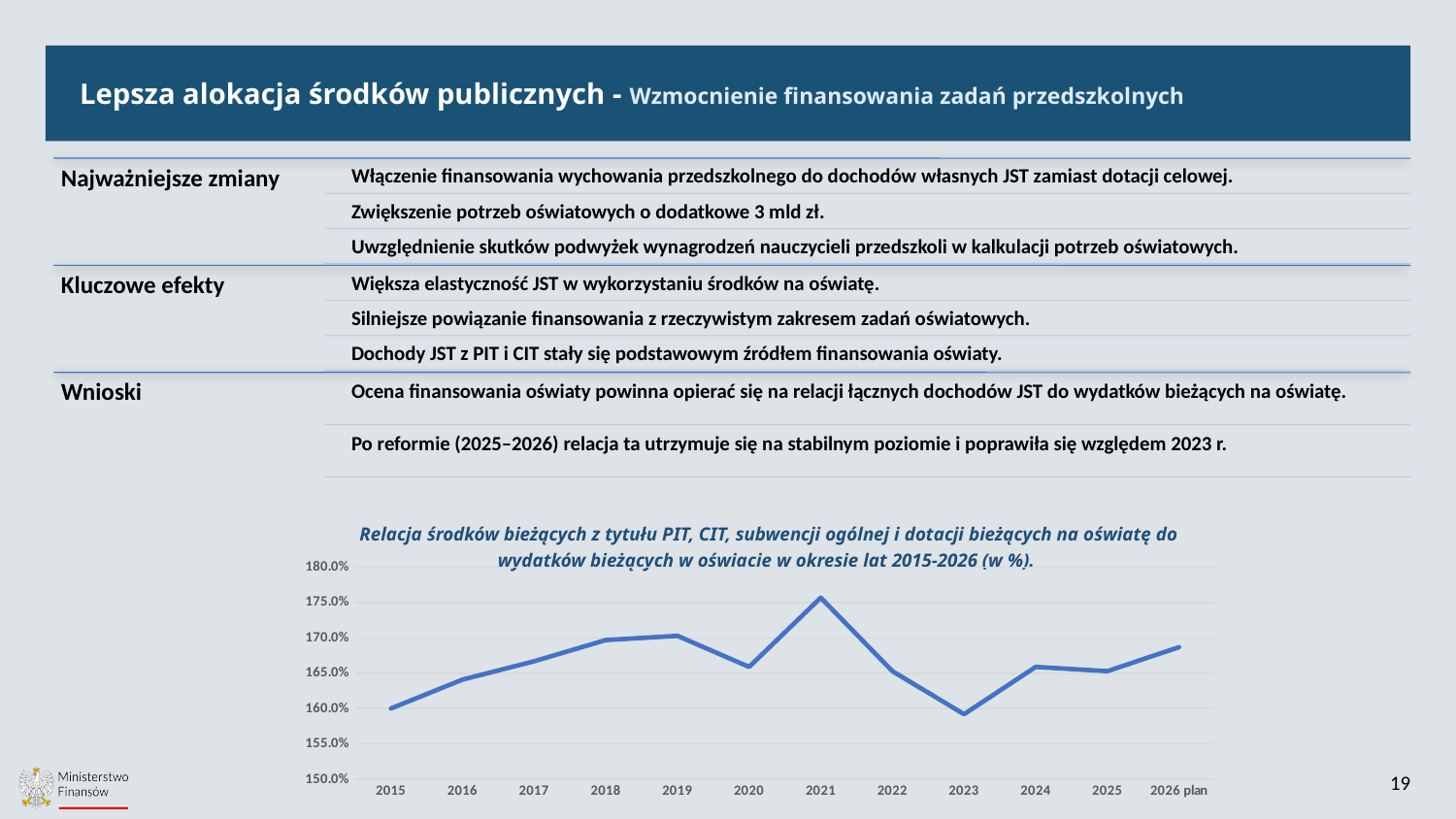
What is the label of the last category on the x axis of the chart? 2026 plan Is the value for 2023 greater or less than 160.0%? less Which year has the higher value, 2015 or 2024? 2024 What kind of chart is shown on the slide? line chart In which year does the line reach its lowest value? 2023 Which year has the higher value, 2019 or 2022? 2019 Is the value for 2018 greater or less than 165.0%? greater In which year does the line reach its highest value? 2021 Is the value for 2021 greater or less than 175.0%? greater Does the line rise or fall between 2015 and 2019? rise How many years (data points) are plotted on the x axis of the chart? 12